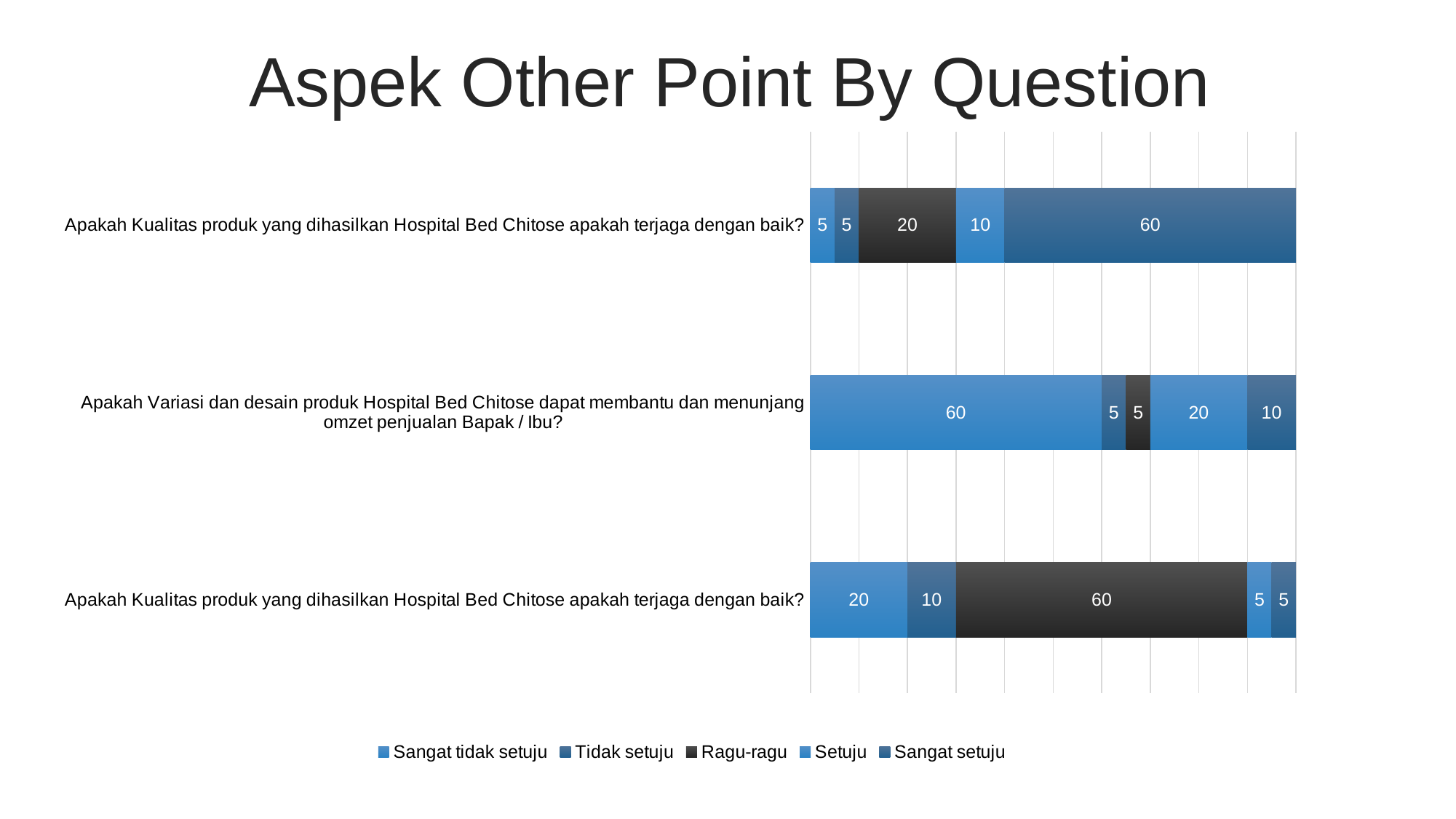
How many series does the legend list? 5 In the bar for 'Apakah Variasi dan desain produk Hospital Bed Chitose dapat membantu dan menunjang omzet penjualan Bapak / Ibu?', which is larger: Setuju or Sangat setuju? Setuju Which series has the largest value in the bar for 'Apakah Variasi dan desain produk Hospital Bed Chitose dapat membantu dan menunjang omzet penjualan Bapak / Ibu?'? Sangat tidak setuju In the bar for 'Apakah Variasi dan desain produk Hospital Bed Chitose dapat membantu dan menunjang omzet penjualan Bapak / Ibu?', what is the difference between the Setuju value and the Sangat setuju value? 10 What is the Ragu-ragu value for the question 'Apakah Variasi dan desain produk Hospital Bed Chitose dapat membantu dan menunjang omzet penjualan Bapak / Ibu?'? 5 What is the total of the stacked bar for the question 'Apakah Variasi dan desain produk Hospital Bed Chitose dapat membantu dan menunjang omzet penjualan Bapak / Ibu?'? 100 How many question categories (bars) are plotted in the chart? 3 What is the Sangat tidak setuju value for the question 'Apakah Variasi dan desain produk Hospital Bed Chitose dapat membantu dan menunjang omzet penjualan Bapak / Ibu?'? 60 What is the title of the slide? Aspek Other Point By Question What is the Sangat setuju value in the top bar of the chart? 60 What is the Setuju value for the question 'Apakah Variasi dan desain produk Hospital Bed Chitose dapat membantu dan menunjang omzet penjualan Bapak / Ibu?'? 20 What kind of chart is shown on the slide? Stacked bar chart